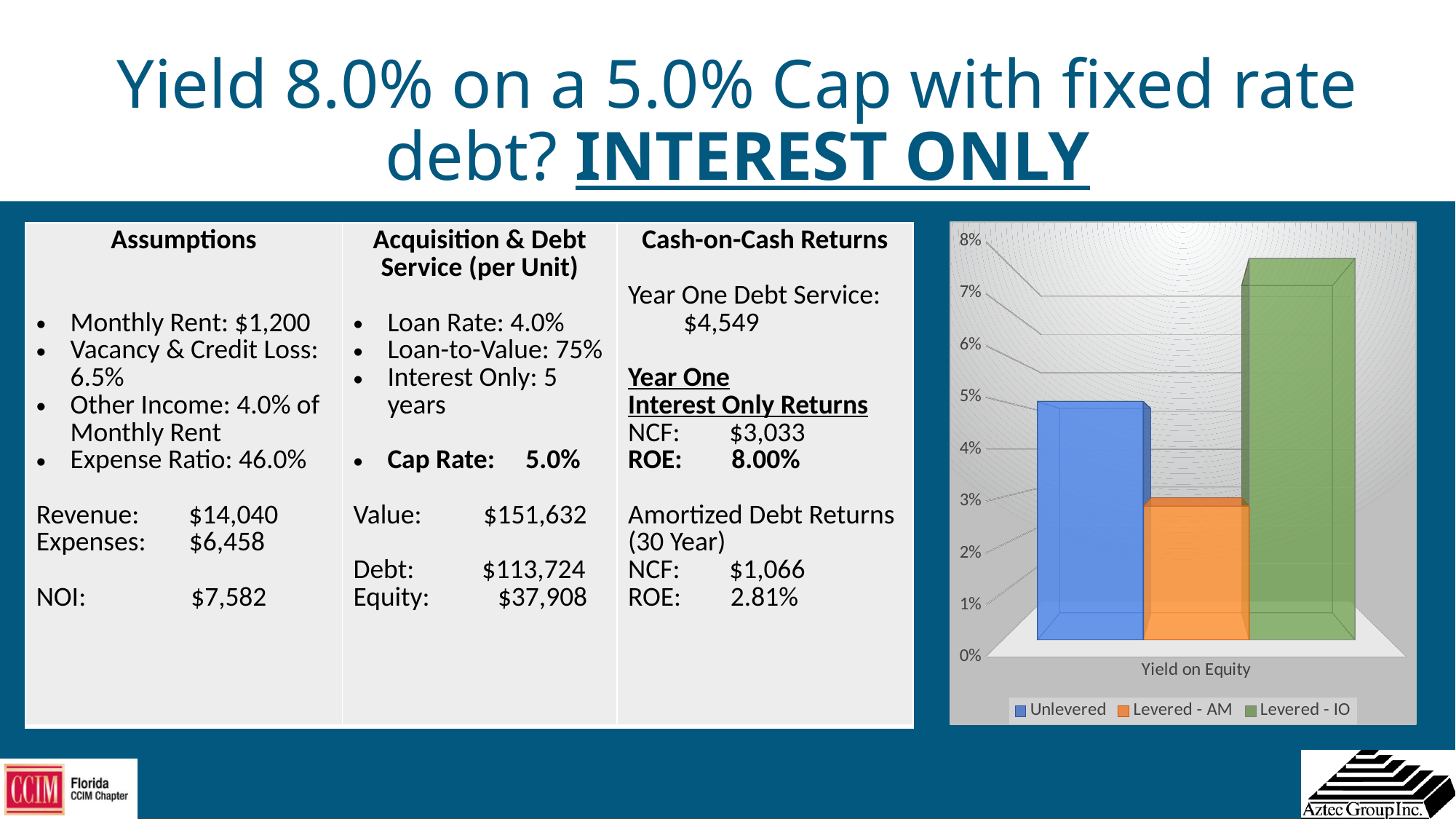
What is the category label shown on the x axis of the chart? Yield on Equity How many series does the chart legend list? 3 What colour is the Levered - IO series in the chart? green Which bar is taller, Unlevered or Levered - AM? Unlevered Is the bar for Unlevered greater or less than 4%? greater Which bar is taller, Levered - IO or Unlevered? Levered - IO Is the bar for Levered - IO greater or less than 7%? greater How many categories are shown on the x axis of the chart? 1 Is the bar for Levered - AM greater or less than 4%? less Which series has the lowest bar in the chart? Levered - AM Which series has the highest bar in the chart? Levered - IO What kind of chart is shown on the slide? bar chart